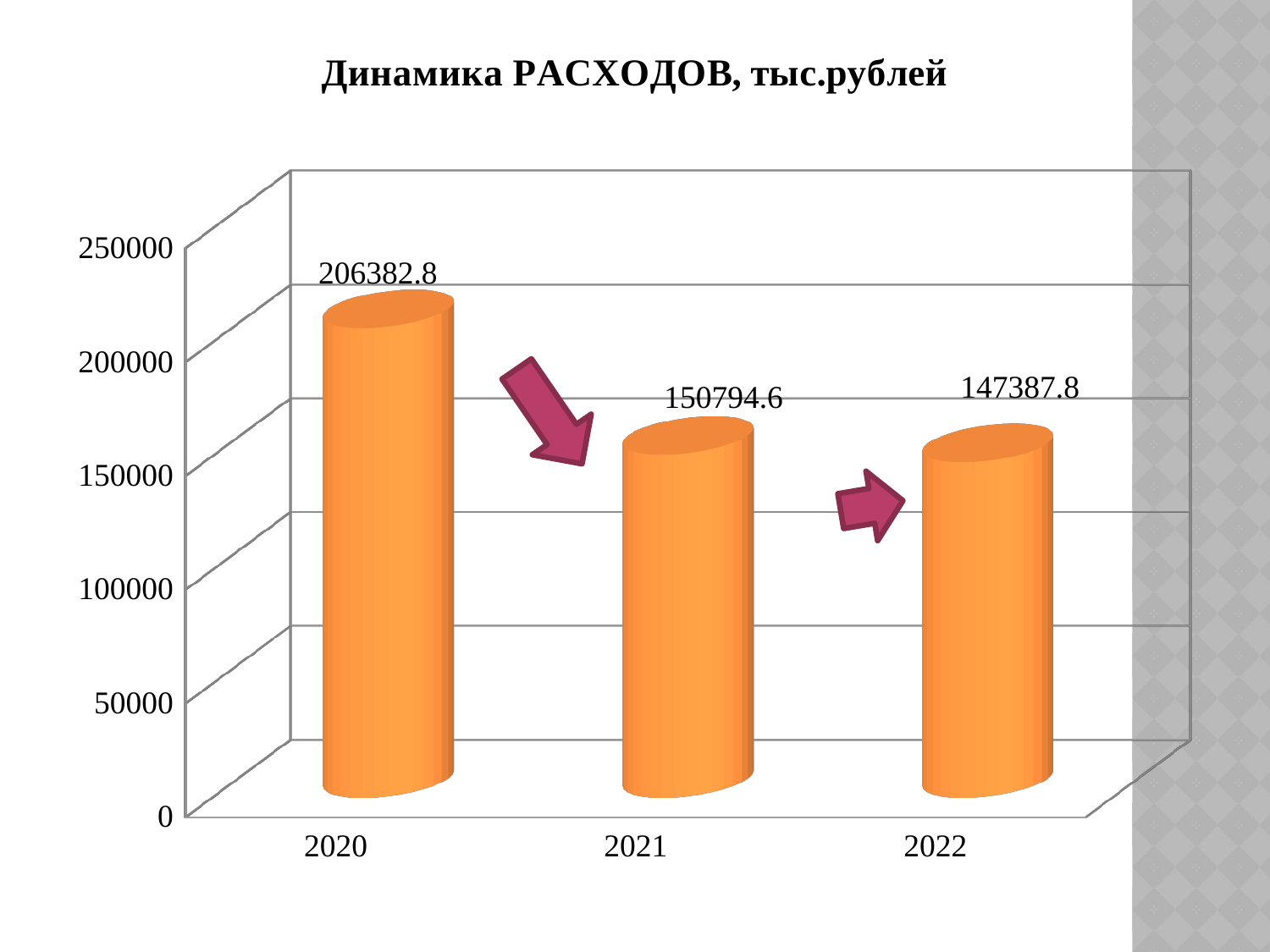
Which year has the highest value? 2020 How many years are shown on the chart? 3 What is the value for 2020? 206382.8 Which is larger, the value for 2021 or the value for 2022? 2021 Is the value for 2020 greater or less than 200000? greater What is the title of the chart? Динамика РАСХОДОВ, тыс.рублей What kind of chart is this? bar chart What is the difference between the values for 2020 and 2021? 55588.2 What is the difference between the values for 2021 and 2022? 3406.8 Which year has the lowest value? 2022 What is the value for 2022? 147387.8 What is the value for 2021? 150794.6